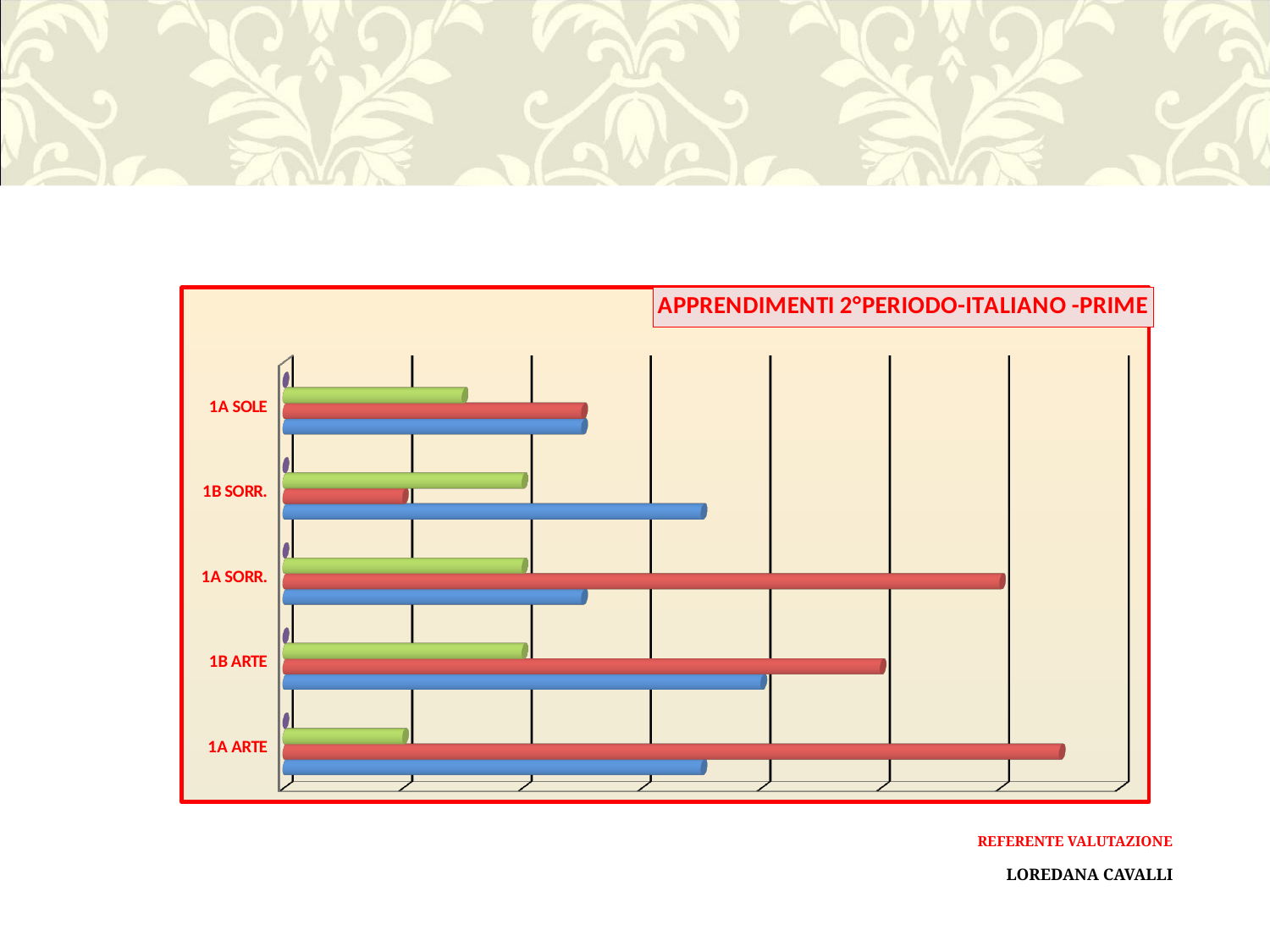
Which class has the shortest red bar? 1B SORR. Which class has the longest blue bar? 1B ARTE What kind of chart is shown on the slide? Bar chart For 1A SORR., which bar is longer, the red one or the blue one? Red Which class is listed at the top of the vertical axis? 1A SOLE Which class has the longest red bar? 1A ARTE What is the title of the chart? APPRENDIMENTI 2°PERIODO-ITALIANO -PRIME How many categories (classes) are shown on the vertical axis of the chart? 5 For 1A ARTE, which bar is longer, the green one or the blue one? Blue For 1B SORR., which bar is longer, the blue one or the red one? Blue How many bars are plotted for each class in the chart? 3 Which class has the shortest green bar? 1A ARTE